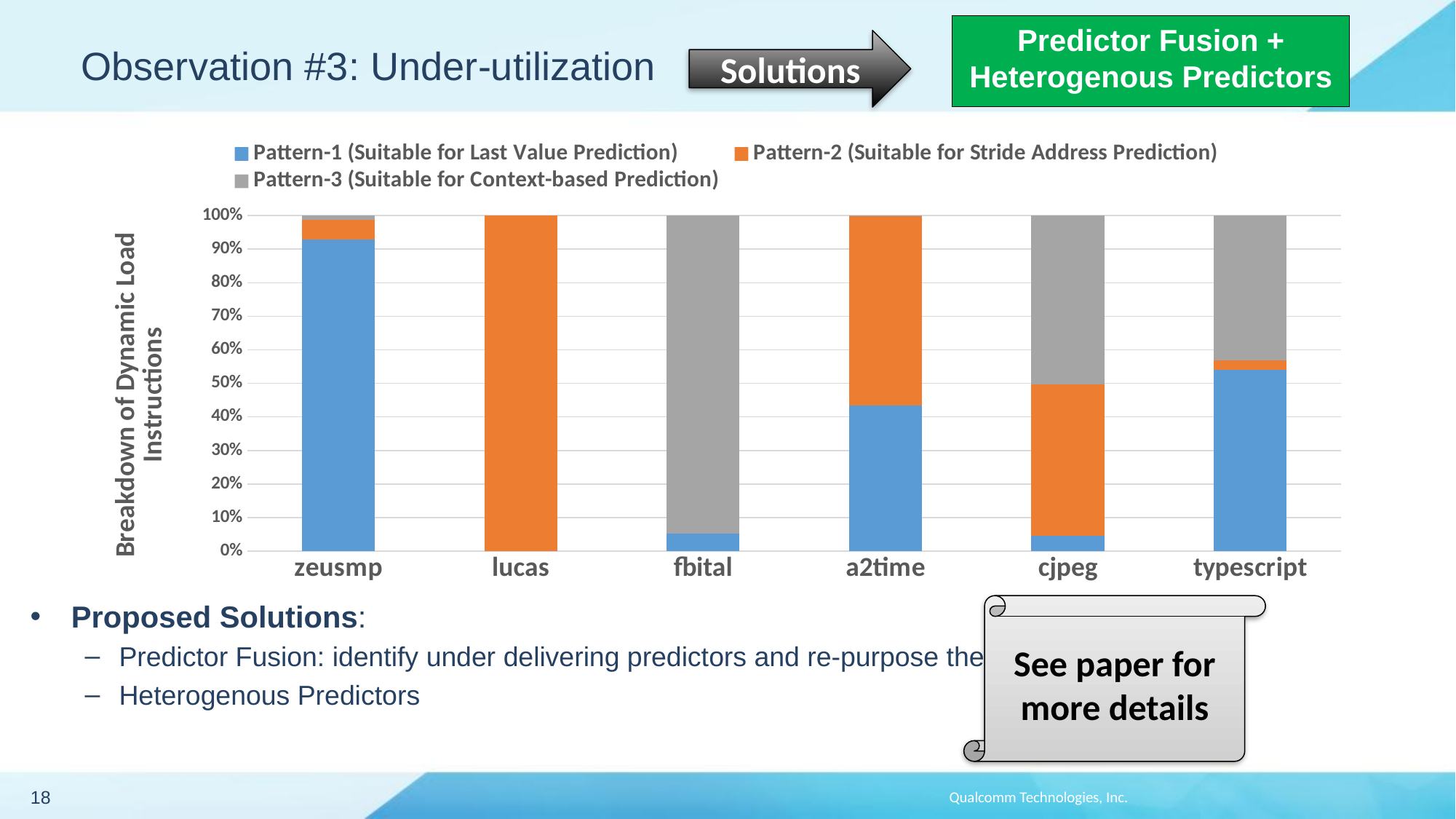
Is the Pattern-1 value for fbital greater or less than 10%? less Which has a larger Pattern-1 share, a2time or cjpeg? a2time What is the title of the chart's y axis? Breakdown of Dynamic Load Instructions How many benchmark categories are shown on the x axis of the chart? 6 Is the Pattern-1 value for zeusmp greater or less than 80%? greater Which benchmark has the largest Pattern-2 (Suitable for Stride Address Prediction) share? lucas What kind of chart is shown on the slide? Stacked bar chart Is the Pattern-1 value for a2time greater or less than 50%? less How many series does the chart's legend list? 3 What colour represents Pattern-2 (Suitable for Stride Address Prediction) in the chart? Orange Which benchmark has the largest Pattern-1 (Suitable for Last Value Prediction) share? zeusmp